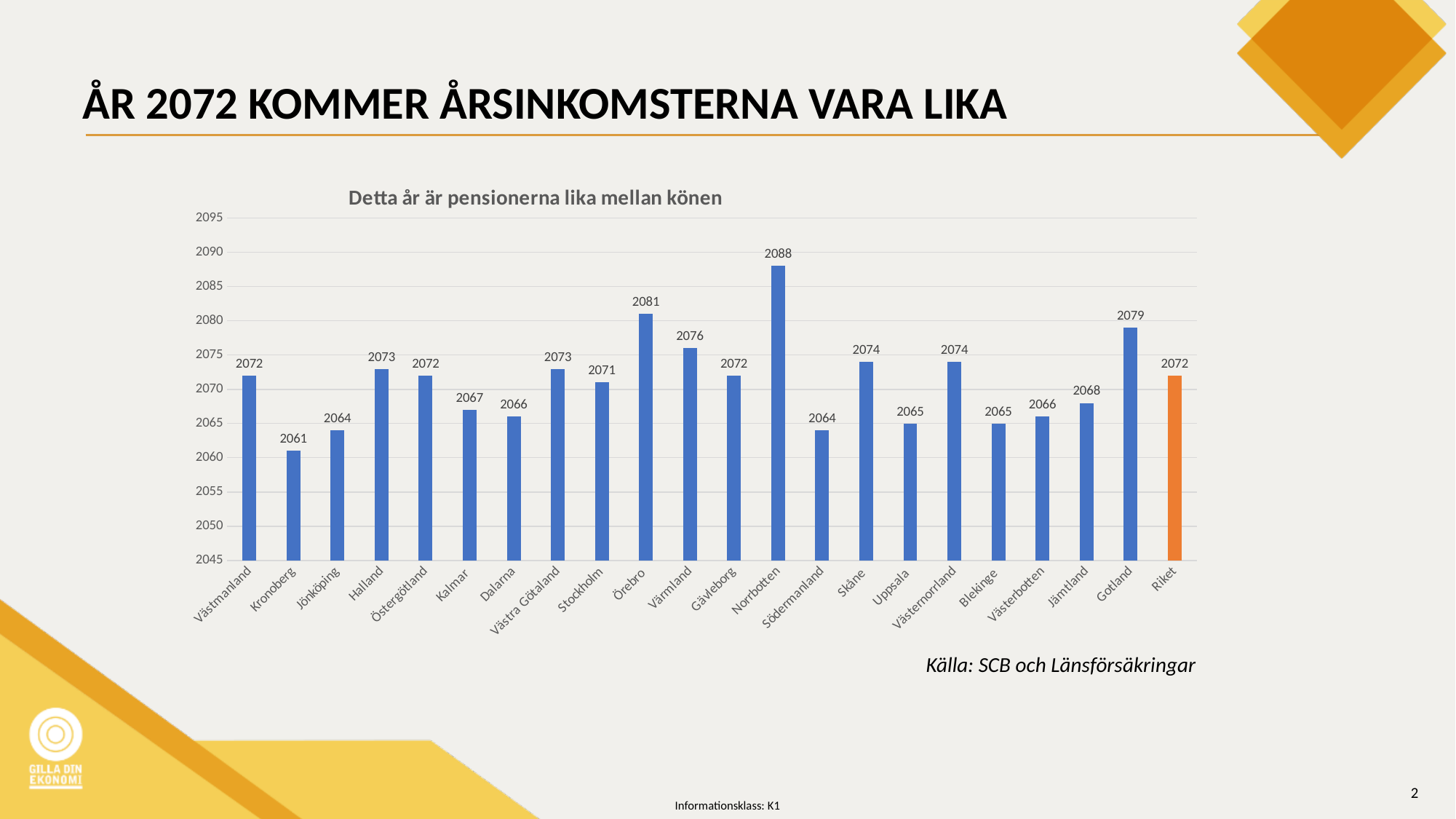
Which is larger, the value for Värmland or the value for Skåne? Värmland Which category has the highest value? Norrbotten What value is shown for Norrbotten? 2088 Which category has the lowest value? Kronoberg What is the difference between the values for Örebro and Riket? 9 What is the difference between the values for Norrbotten and Kronoberg? 27 What is the title of the chart? Detta år är pensionerna lika mellan könen What value is shown for Stockholm? 2071 What kind of chart is shown on the slide? Bar chart What value is shown for Riket? 2072 How many categories are shown on the x axis? 22 What value is shown for Gotland? 2079